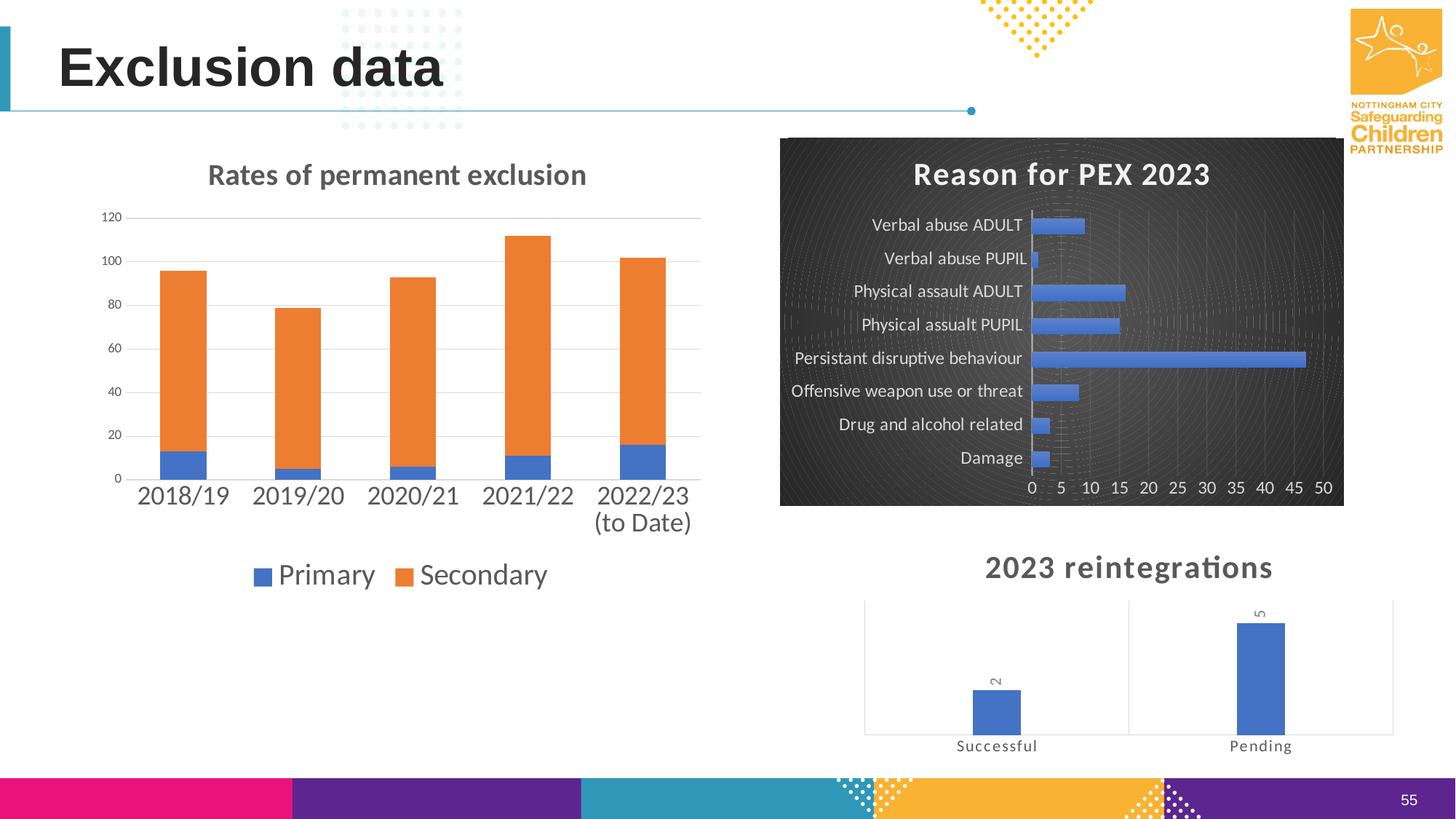
In the 'Reason for PEX 2023' chart, which reason has the longest bar? Persistant disruptive behaviour In the 'Rates of permanent exclusion' chart, how many years are shown on the x axis? 5 In the 'Reason for PEX 2023' chart, how many reasons are listed? 8 In the 'Rates of permanent exclusion' chart, how many series does the legend list? 2 In the 'Rates of permanent exclusion' chart, which year has the highest total bar? 2021/22 In the 'Rates of permanent exclusion' chart, is the total for 2021/22 greater or less than 100? greater In the 'Reason for PEX 2023' chart, which reason has the shortest bar? Verbal abuse PUPIL In the '2023 reintegrations' chart, what is the value for Pending? 5 In the 'Rates of permanent exclusion' chart, which series is shown in orange? Secondary In the 'Reason for PEX 2023' chart, is the value for Persistant disruptive behaviour greater or less than 45? greater In the '2023 reintegrations' chart, what is the difference between Pending and Successful? 3 In the 'Rates of permanent exclusion' chart, which year has the lowest total bar? 2019/20